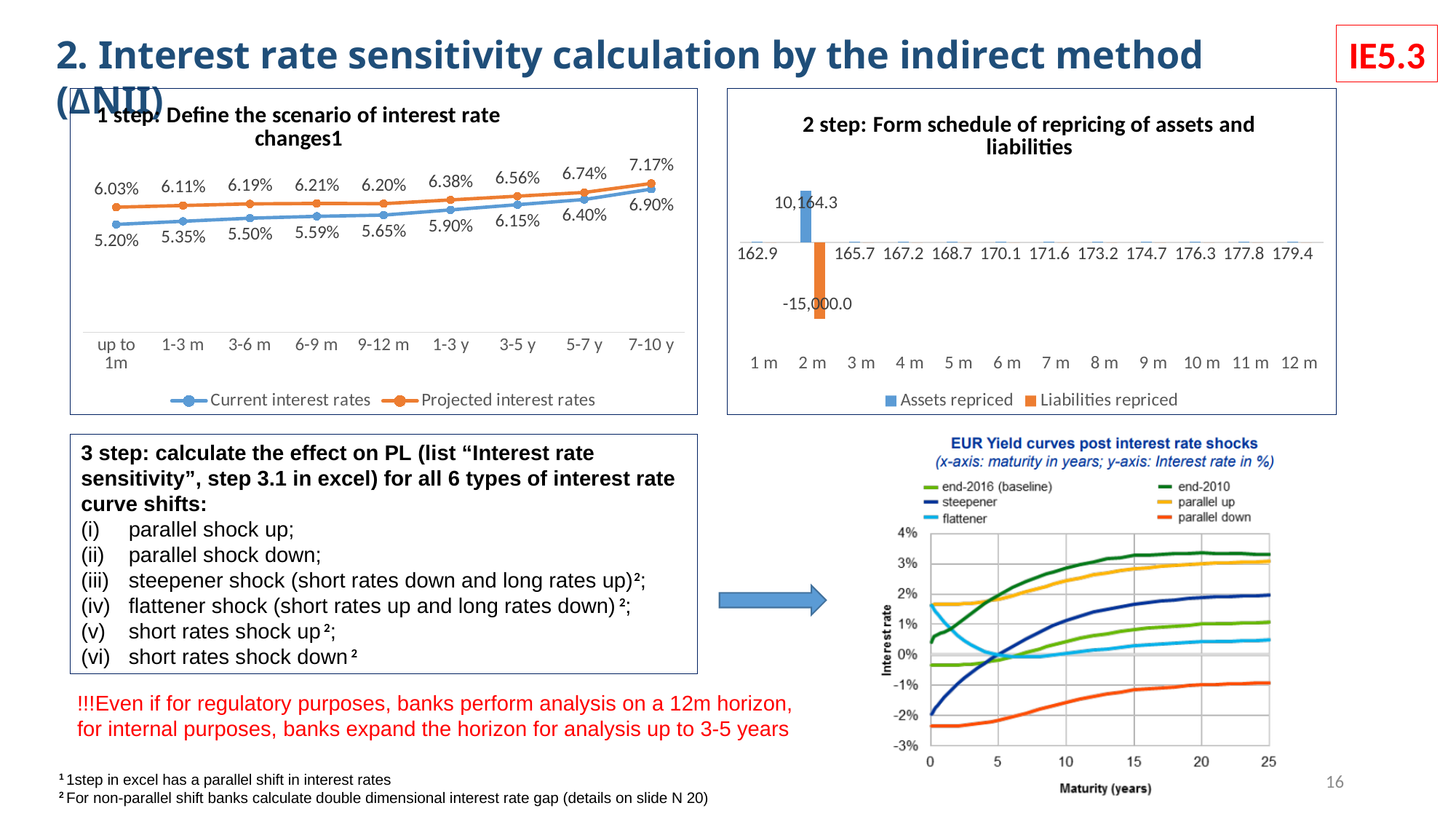
In the '2 step' chart, how many series does the legend list? 2 In the '1 step' chart, what is the difference between the projected and current interest rates for the 1-3 y bucket? 0.48% In the '1 step' chart, what is the current interest rate for the 3-5 y bucket? 6.15% In the '1 step' chart, which bucket has the lowest current interest rate? up to 1m In the '1 step' chart, what is the projected interest rate for the 'up to 1m' bucket? 6.03% In the '1 step' chart, how many maturity buckets are shown on the x axis? 9 In the 'EUR Yield curves post interest rate shocks' chart, how many series does the legend list? 6 In the '2 step' chart, what is the value of Assets repriced at 2 m? 10,164.3 In the '1 step' chart, which is larger for the 9-12 m bucket: the current or the projected interest rate? Projected interest rates In the '1 step' chart, what is the projected interest rate for the 7-10 y bucket? 7.17% In the '2 step' chart, what is the value of Liabilities repriced at 2 m? -15,000.0 In the '1 step' chart, do the current interest rates rise or fall as maturity increases along the x axis? rise